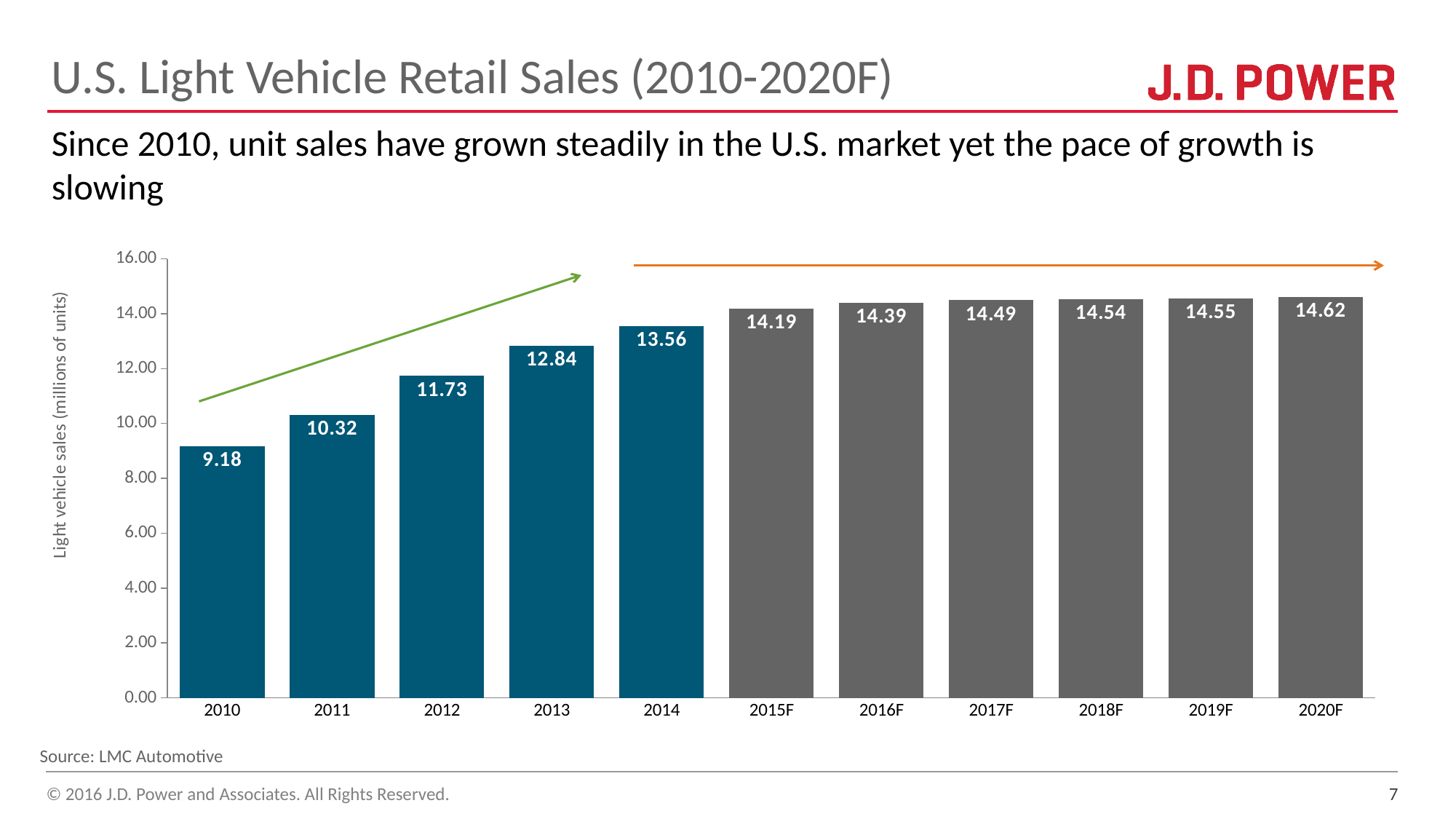
What is the difference between the values for 2014 and 2010? 4.38 Which is larger, the value for 2012 or the value for 2013? 2013 What is the difference between the values for 2020F and 2015F? 0.43 Which year has the lowest value? 2010 How many years are shown on the x axis? 11 Which year has the highest value? 2020F What kind of chart is shown? bar chart Do the values rise or fall from 2010 to 2020F? rise Is the value for 2011 greater or less than 12.00? less What is the value for 2018F? 14.54 What is the value for 2014? 13.56 What is the value for 2010? 9.18